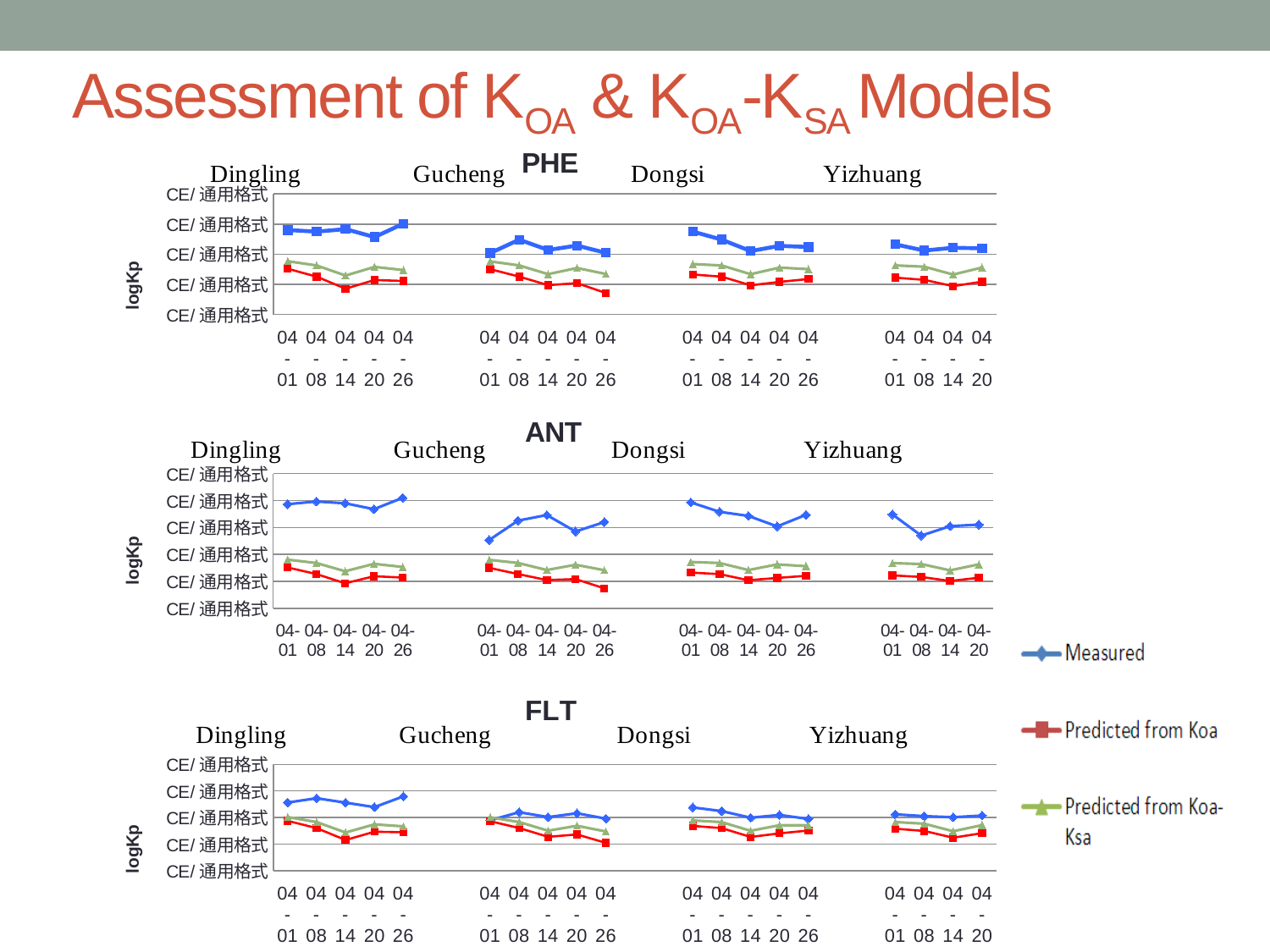
In the PHE chart at Dongsi, which series is lower: Predicted from Koa or Predicted from Koa-Ksa? Predicted from Koa How many series does the legend list for the charts on this slide? 3 What are the titles of the three charts on the slide, from top to bottom? PHE, ANT, FLT What kind of chart is the PHE chart? line chart In the FLT chart at Dingling, which series has the highest values? Measured In the ANT chart at Gucheng, which series has the lowest values: Measured, Predicted from Koa, or Predicted from Koa-Ksa? Predicted from Koa What are the three series named in the legend? Measured, Predicted from Koa, Predicted from Koa-Ksa What kind of chart is the FLT chart? line chart In the FLT chart, how many dates are plotted for the Dingling site? 5 In the ANT chart at Dingling, which series is higher: Measured or Predicted from Koa? Measured In the PHE chart, how many dates are plotted for the Yizhuang site? 4 How many sampling sites are shown along the x axis of the ANT chart? 4